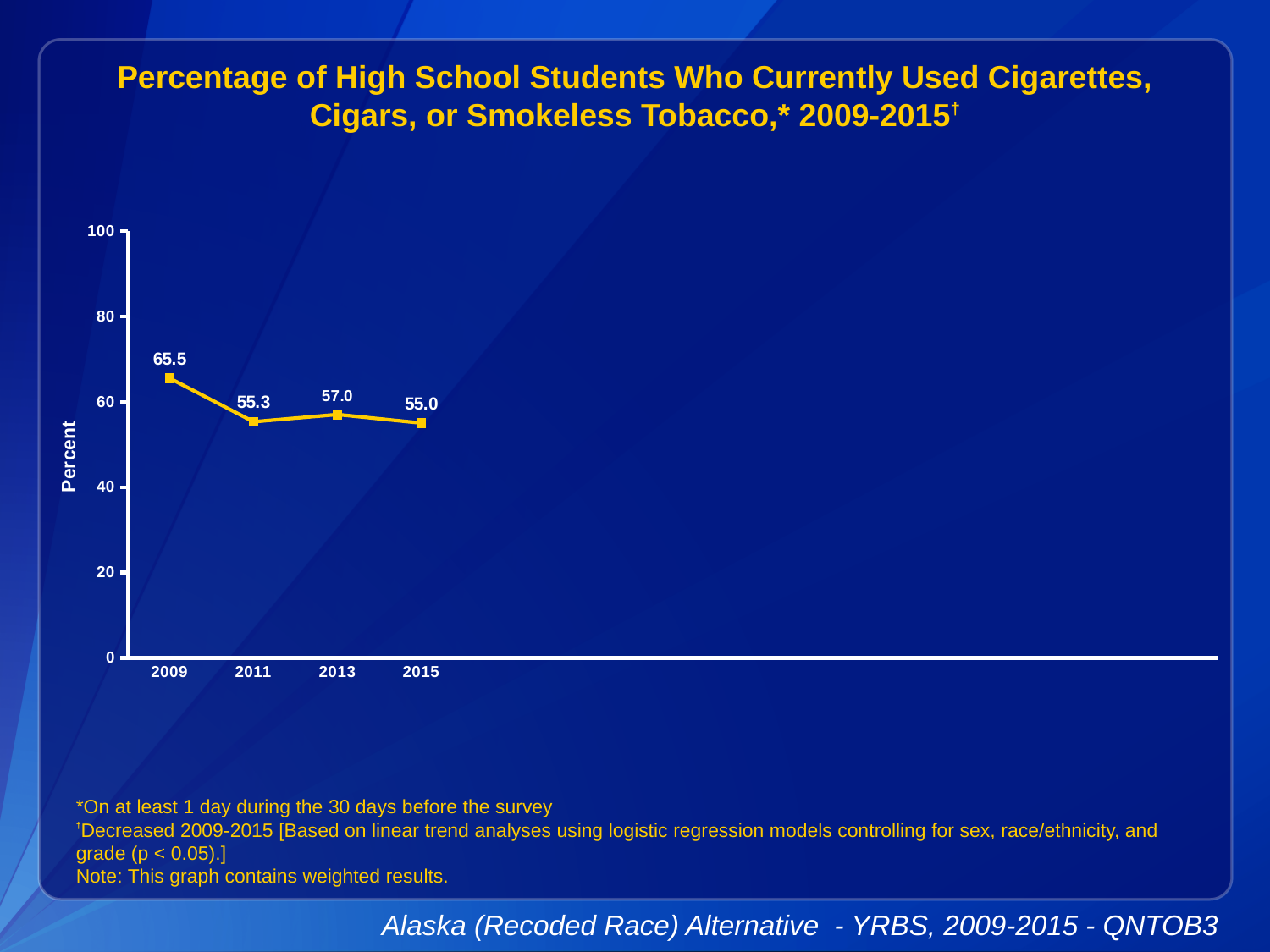
By how many percentage points did the value change from 2009 to 2015? 10.5 What was the percentage of high school students who currently used cigarettes, cigars, or smokeless tobacco in 2015? 55.0 What is the difference between the 2013 and 2011 values? 1.7 Which year had the lowest percentage of students who currently used cigarettes, cigars, or smokeless tobacco? 2015 How many years are plotted on the chart? 4 What is the label on the vertical axis of the chart? Percent What was the percentage of high school students who currently used cigarettes, cigars, or smokeless tobacco in 2011? 55.3 What type of chart is shown on the slide? Line chart Which year had the highest percentage of students who currently used cigarettes, cigars, or smokeless tobacco? 2009 What was the percentage of high school students who currently used cigarettes, cigars, or smokeless tobacco in 2013? 57.0 What was the percentage of high school students who currently used cigarettes, cigars, or smokeless tobacco in 2009? 65.5 Which year had a higher value, 2011 or 2013? 2013